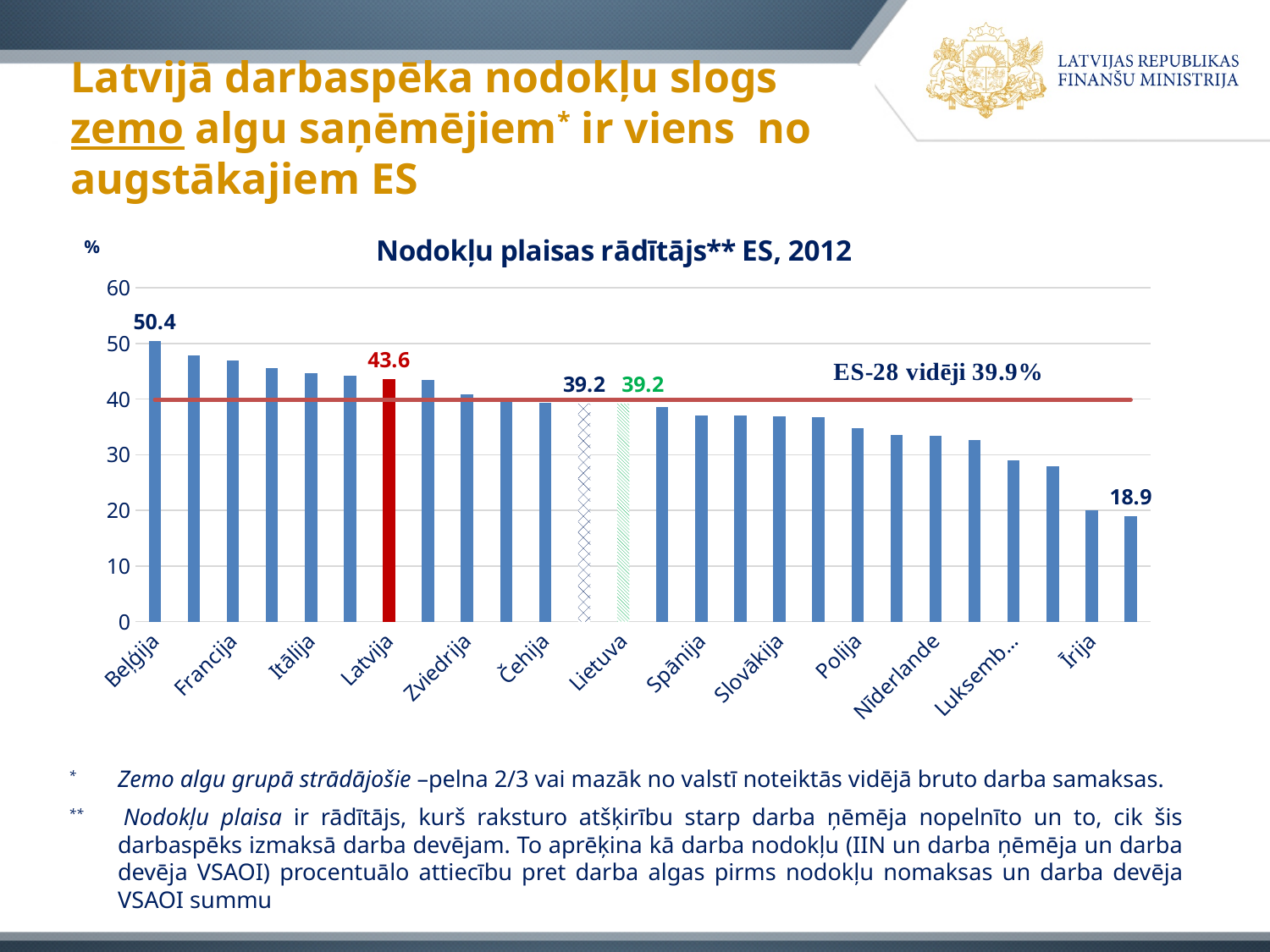
What is the value for Latvija? 43.6 What is the value for Beļģija? 50.4 What kind of chart is shown on the slide? bar chart What is the difference between the values for Beļģija and Latvija? 6.8 What is the title of the chart? Nodokļu plaisas rādītājs** ES, 2012 What colour is the bar for Latvija? red What is the ES-28 average value shown by the horizontal line? 39.9% Is the value for Francija greater or less than 40? greater Which is larger: the value for Latvija or the ES-28 average? Latvija Which country has the highest value in the chart? Beļģija Do the values generally rise or fall from left to right along the x axis? fall Is the value for Īrija greater or less than 30? less